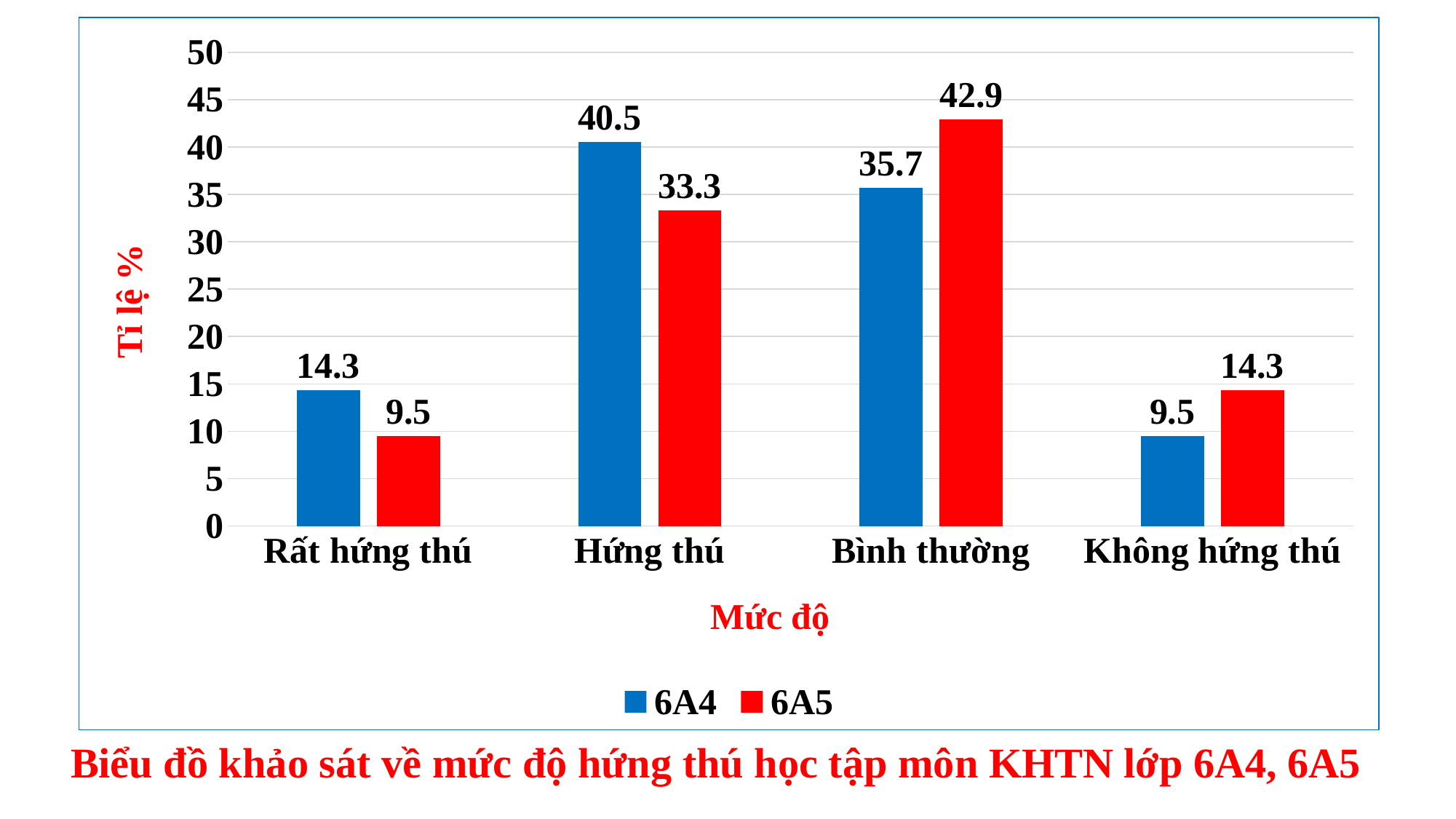
What is the label of the y axis? Tỉ lệ % In the "Hứng thú" category, which series has the larger value, 6A4 or 6A5? 6A4 What kind of chart is shown on the slide? bar chart Which category has the highest value for 6A4? Hứng thú How many series does the legend list? 2 What is the difference between the 6A5 and 6A4 values in the "Bình thường" category? 7.2 Is the value for 6A4 in the "Không hứng thú" category greater or less than 10? less What is the value for 6A4 in the "Hứng thú" category? 40.5 Which category has the lowest value for 6A5? Rất hứng thú How many categories are shown on the x axis? 4 What is the value for 6A5 in the "Rất hứng thú" category? 9.5 What is the value for 6A5 in the "Bình thường" category? 42.9